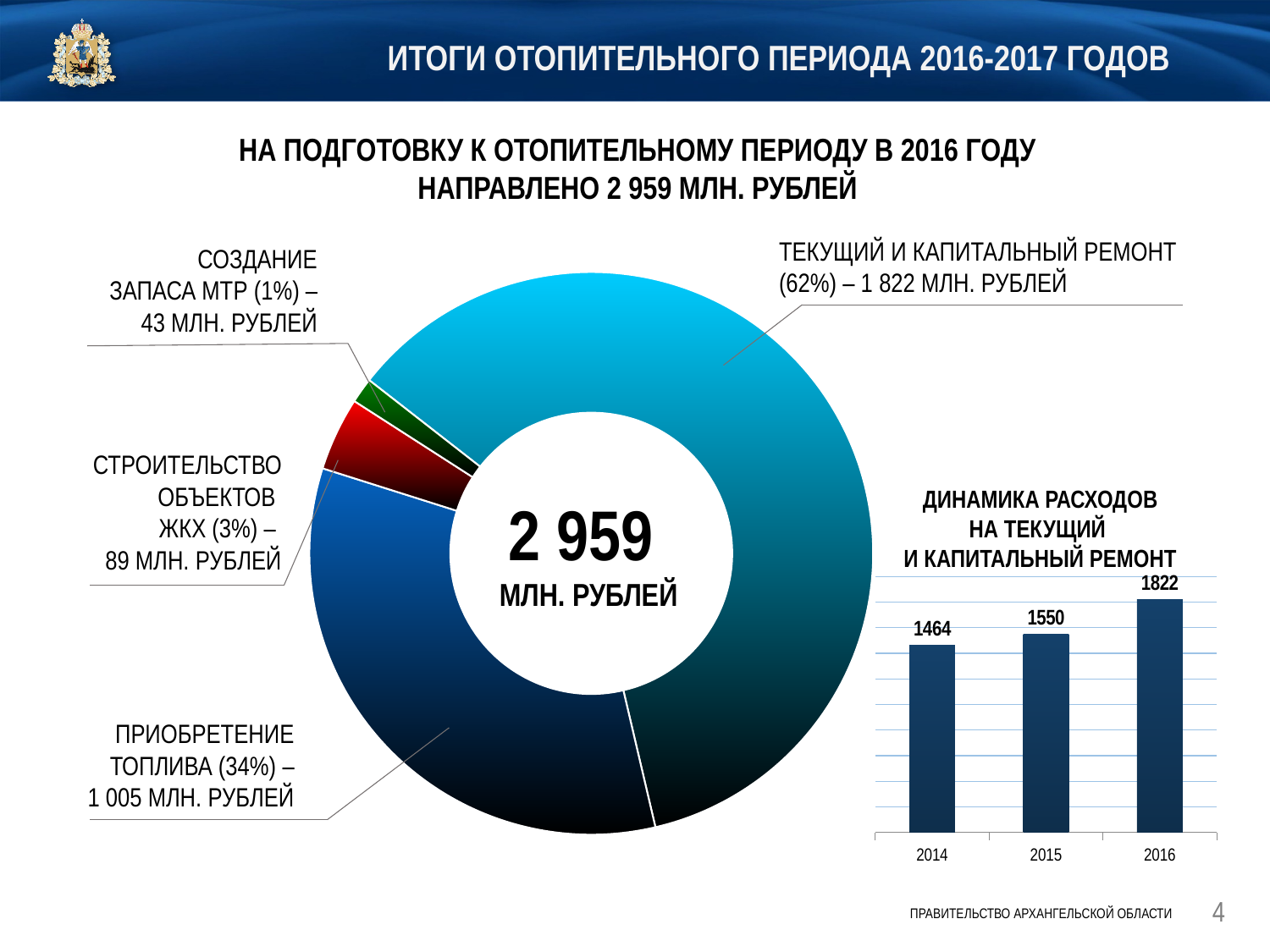
In the chart ДИНАМИКА РАСХОДОВ НА ТЕКУЩИЙ И КАПИТАЛЬНЫЙ РЕМОНТ, what is the difference between the 2016 and 2014 values? 358 In the donut chart on the left, what share does ПРИОБРЕТЕНИЕ ТОПЛИВА have? 34% In the donut chart on the left, how many categories are shown? 4 In the donut chart on the left, what amount is shown for ТЕКУЩИЙ И КАПИТАЛЬНЫЙ РЕМОНТ? 1 822 МЛН. РУБЛЕЙ In the chart ДИНАМИКА РАСХОДОВ НА ТЕКУЩИЙ И КАПИТАЛЬНЫЙ РЕМОНТ, what is the value for 2015? 1550 In the donut chart on the left, what amount is shown for СТРОИТЕЛЬСТВО ОБЪЕКТОВ ЖКХ? 89 МЛН. РУБЛЕЙ In the donut chart on the left, which category has the largest share? ТЕКУЩИЙ И КАПИТАЛЬНЫЙ РЕМОНТ In the donut chart on the left, which category has the smallest share? СОЗДАНИЕ ЗАПАСА МТР In the chart ДИНАМИКА РАСХОДОВ НА ТЕКУЩИЙ И КАПИТАЛЬНЫЙ РЕМОНТ, do the values rise or fall from 2014 to 2016? rise What kind of chart is ДИНАМИКА РАСХОДОВ НА ТЕКУЩИЙ И КАПИТАЛЬНЫЙ РЕМОНТ? bar chart In the donut chart on the left, what total is shown in the centre? 2 959 МЛН. РУБЛЕЙ In the chart ДИНАМИКА РАСХОДОВ НА ТЕКУЩИЙ И КАПИТАЛЬНЫЙ РЕМОНТ, which year has the lowest value? 2014